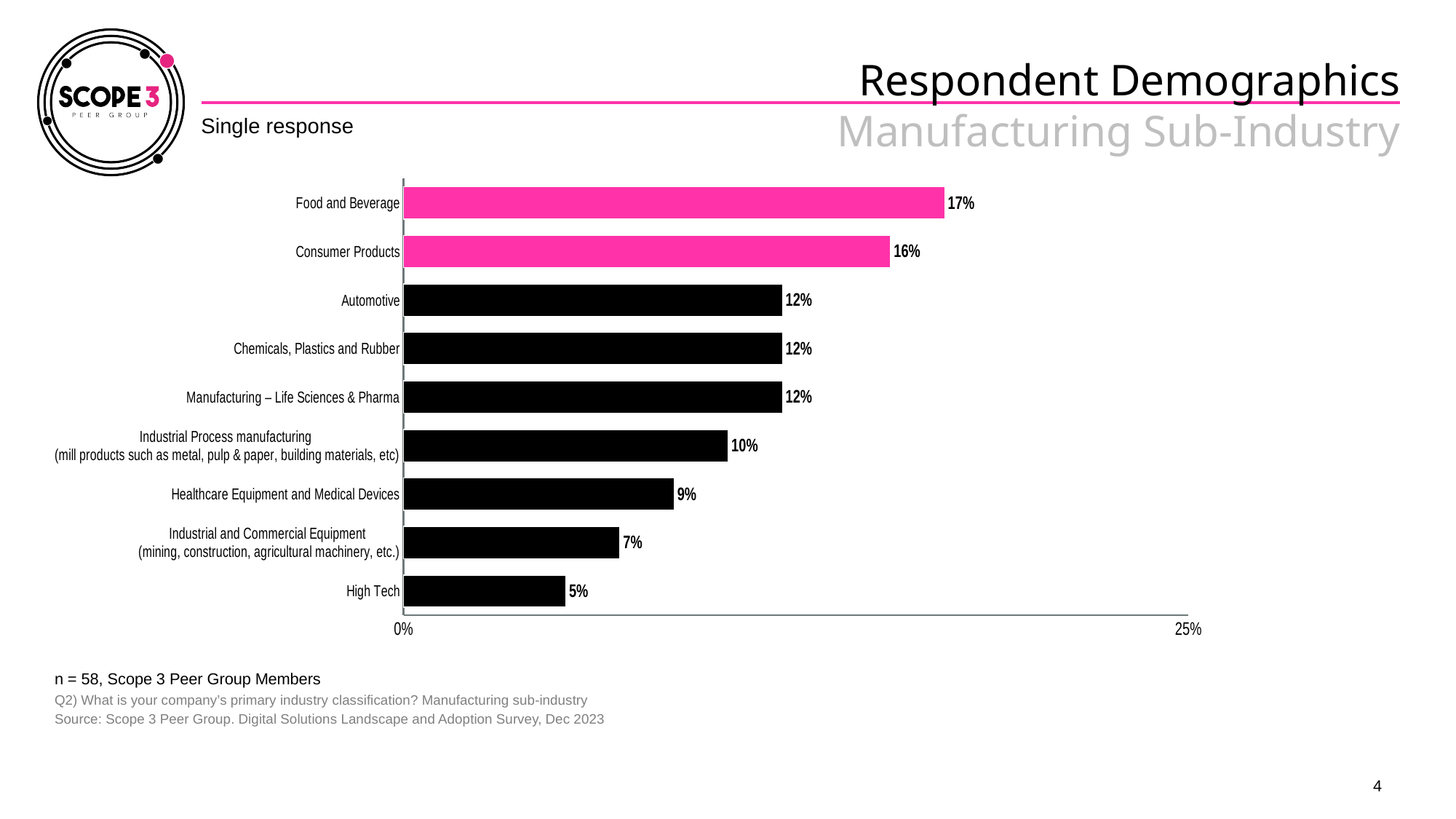
What is the value for Consumer Products? 16% Is the value for Consumer Products greater or less than 25%? less What is the value for Healthcare Equipment and Medical Devices? 9% Which is larger, the value for Automotive or the value for Industrial Process manufacturing? Automotive Which manufacturing sub-industry has the lowest share of respondents? High Tech How many categories have a value of 12%? 3 What is the difference between the values for Food and Beverage and High Tech? 12% Which manufacturing sub-industry has the highest share of respondents? Food and Beverage What percentage of respondents are in Food and Beverage? 17% How many manufacturing sub-industry categories are shown in the chart? 9 What kind of chart is shown on the slide? bar chart Which bars are coloured pink rather than black? Food and Beverage and Consumer Products